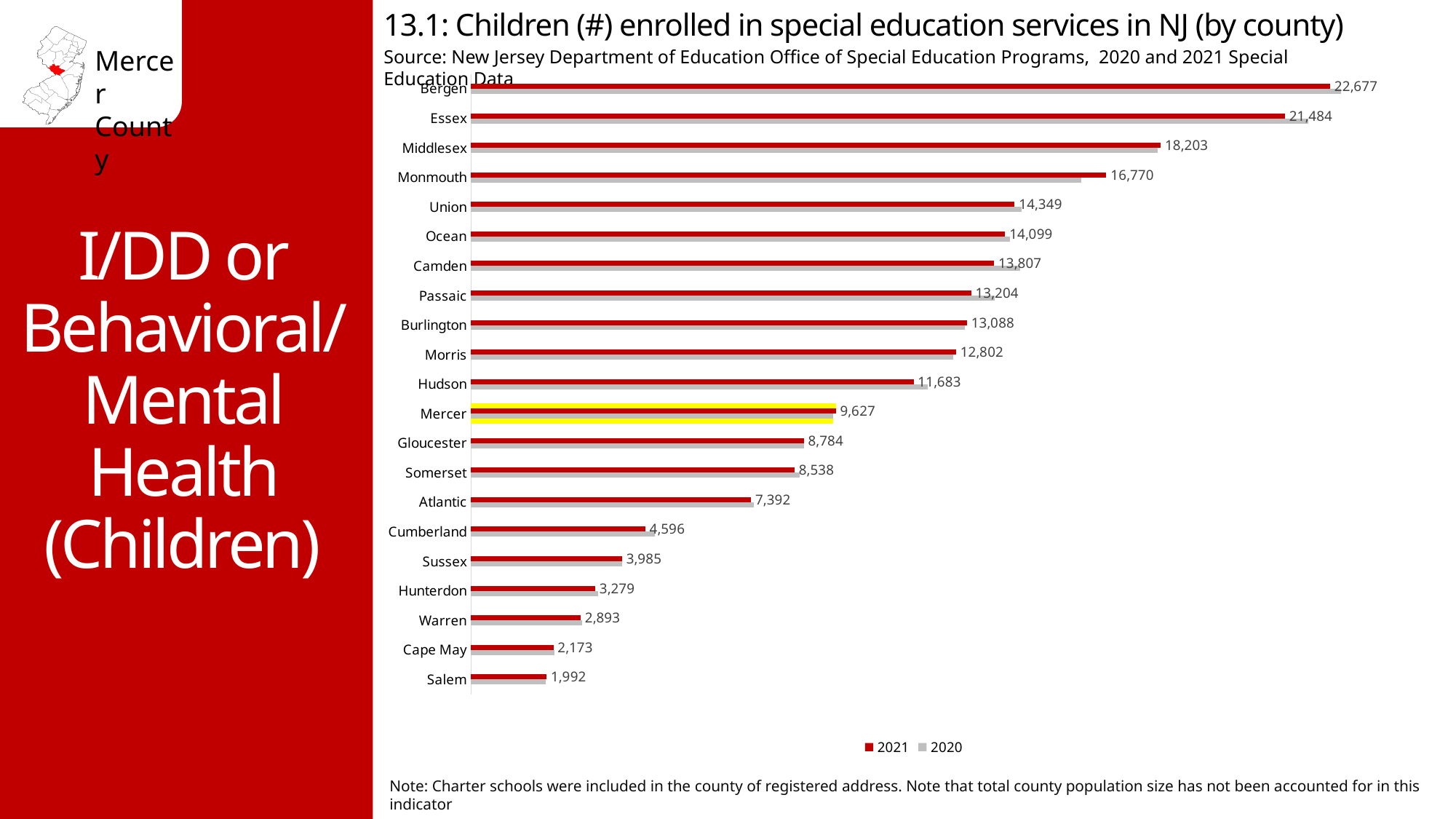
Which county has the lowest 2021 value? Salem What is the 2021 value for Cumberland County? 4,596 How many counties are shown on the chart? 21 What is the difference between the 2021 values for Mercer and Gloucester? 843 Which county has the highest 2021 value? Bergen What kind of chart is shown? Bar chart Which has a larger 2021 value, Hudson or Mercer? Hudson What is the 2021 value for Bergen County? 22,677 Which county's bars are highlighted in yellow? Mercer What is the difference between the 2021 values for Bergen and Essex? 1,193 What is the 2021 value for Mercer County? 9,627 How many series does the legend list? 2